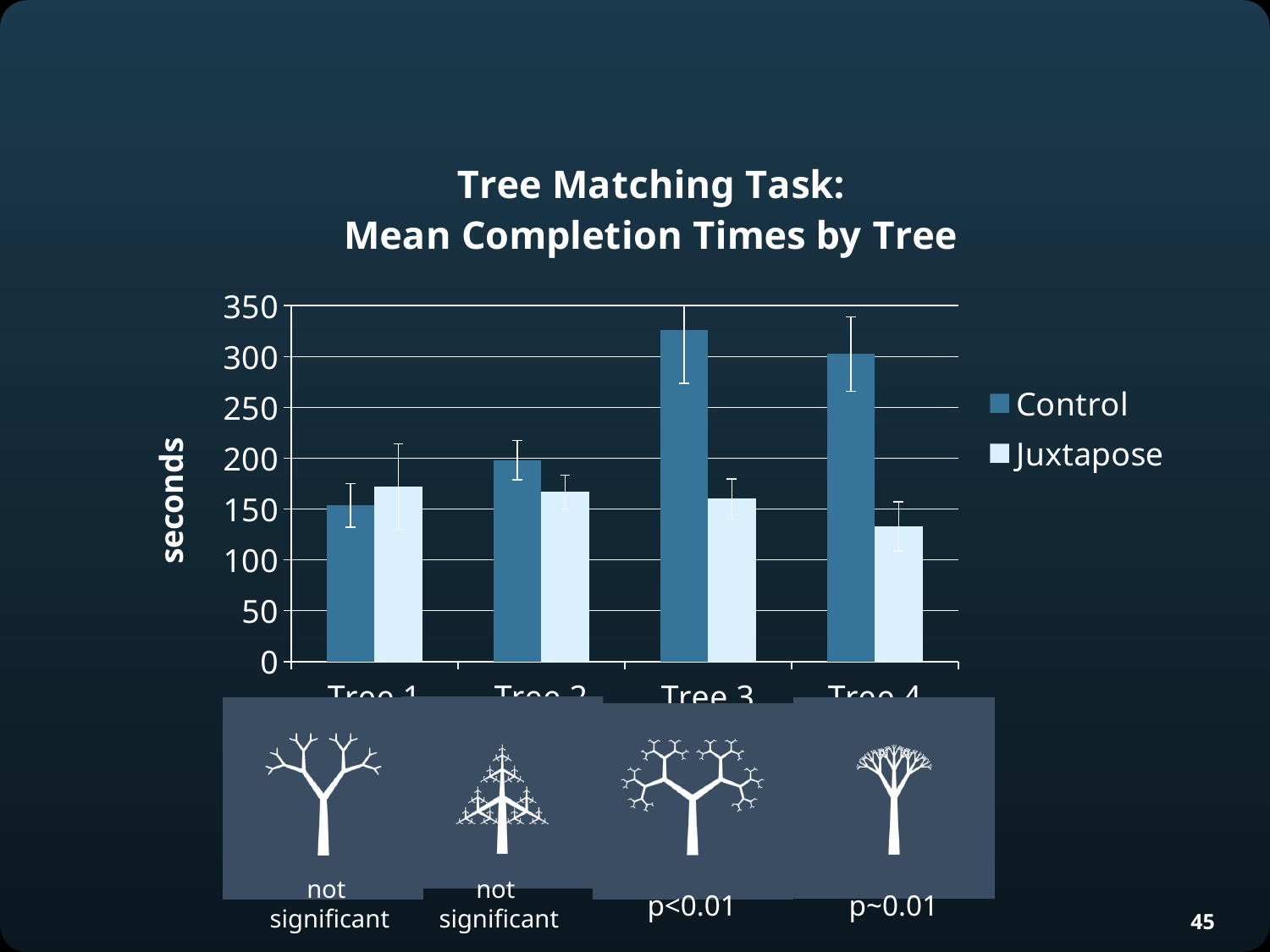
What is the title of the chart? Tree Matching Task: Mean Completion Times by Tree For which tree is the Control completion time highest? Tree 3 For Tree 1, which series has the larger mean completion time, Control or Juxtapose? Juxtapose For Tree 3, which series has the larger mean completion time, Control or Juxtapose? Control Is the Juxtapose value for Tree 4 greater or less than 150? less What is the label on the vertical axis? seconds Is the Control value for Tree 3 greater or less than 300? greater How many series does the legend list? 2 What kind of chart is shown on the slide? bar chart For which tree is the Juxtapose completion time lowest? Tree 4 Is the Juxtapose value for Tree 1 greater or less than 150? greater How many tree categories are plotted on the x axis? 4